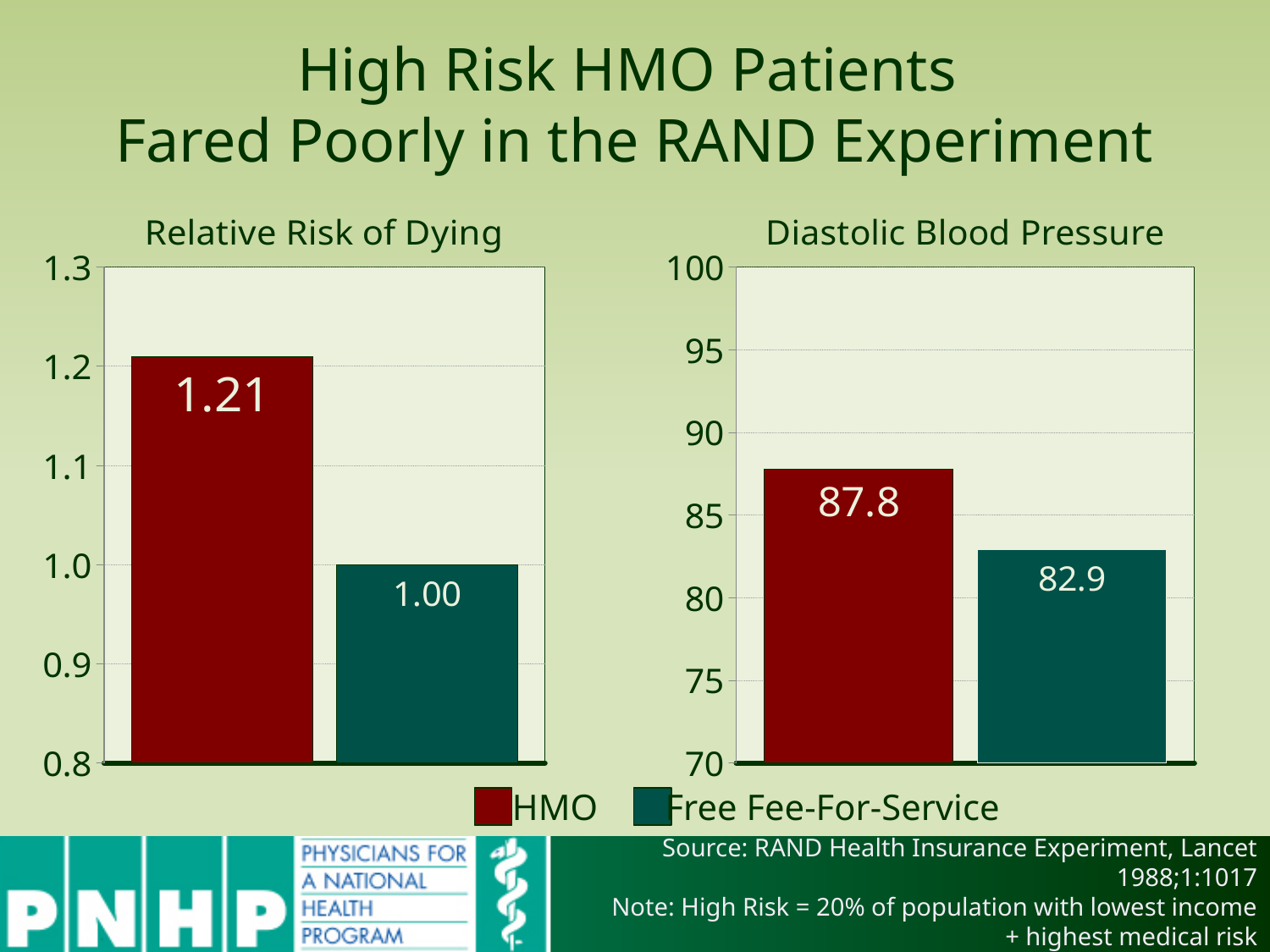
In the Diastolic Blood Pressure chart, which group has the higher value? HMO In the Relative Risk of Dying chart, what is the value for HMO? 1.21 What colour are the HMO bars? Dark red In the Diastolic Blood Pressure chart, is the value for HMO greater or less than 85? greater In the Relative Risk of Dying chart, what is the difference between the HMO and Free Fee-For-Service values? 0.21 In the Diastolic Blood Pressure chart, what is the difference between the HMO and Free Fee-For-Service values? 4.9 What kind of chart is the Relative Risk of Dying chart? Bar chart How many series does the legend list? 2 In the Diastolic Blood Pressure chart, what is the value for Free Fee-For-Service? 82.9 In the Diastolic Blood Pressure chart, what is the value for HMO? 87.8 In the Relative Risk of Dying chart, what is the value for Free Fee-For-Service? 1.00 In the Relative Risk of Dying chart, which group has the lower value? Free Fee-For-Service